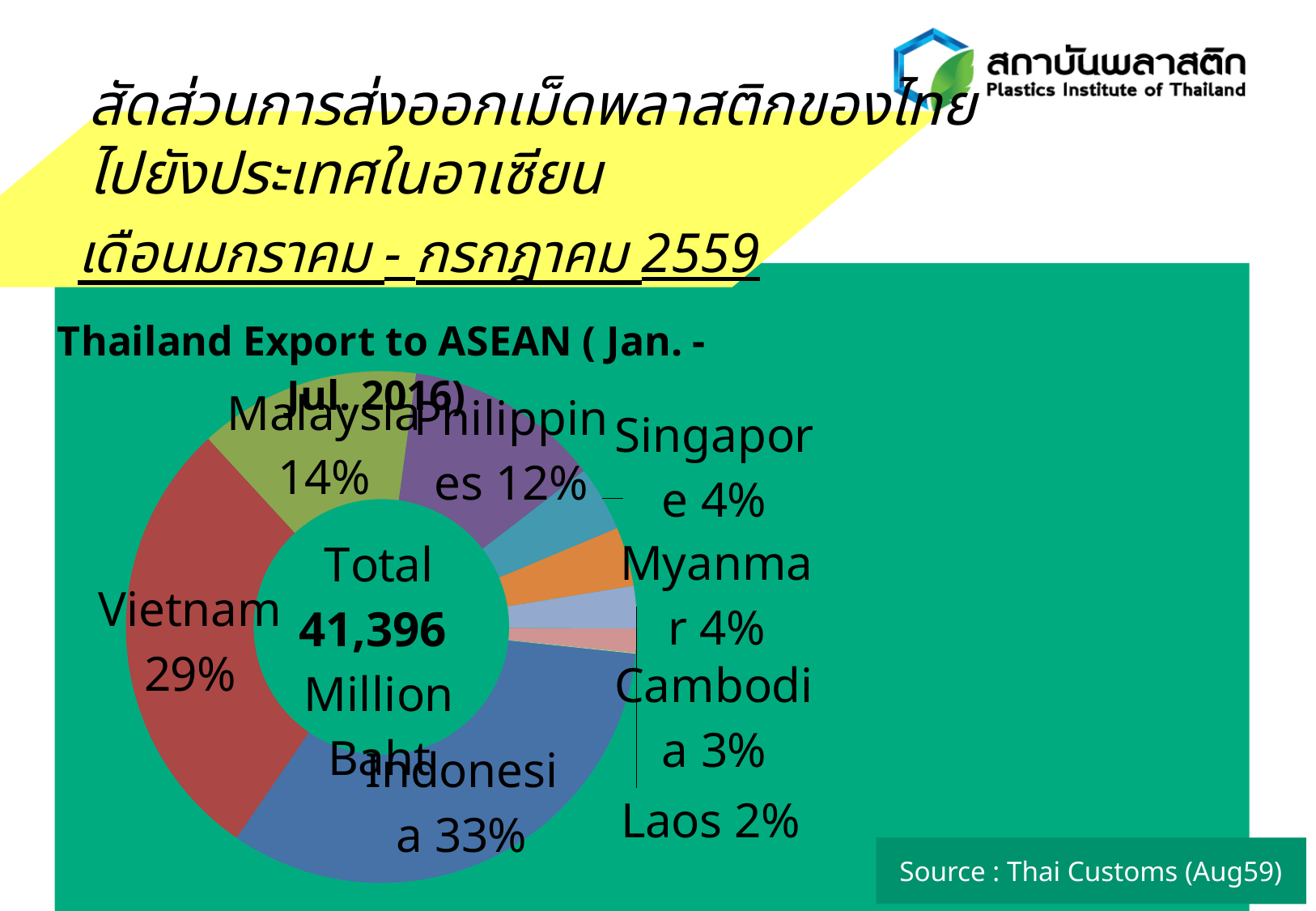
What share of Thailand's plastic resin exports to ASEAN went to Indonesia? 33% Which has a larger share, Malaysia or the Philippines? Malaysia Which country has the largest share of Thailand's exports to ASEAN? Indonesia What percentage is shown for Cambodia? 3% What kind of chart is shown on the slide? Doughnut (pie) chart What share of exports went to Vietnam? 29% What percentage is shown for the Philippines? 12% What total value is shown in the centre of the chart? 41,396 Million Baht How many countries are shown in the chart? 8 What is the difference in percentage points between Indonesia's and Vietnam's shares? 4 What percentage is shown for Malaysia? 14% Which country has the smallest share in the chart? Laos